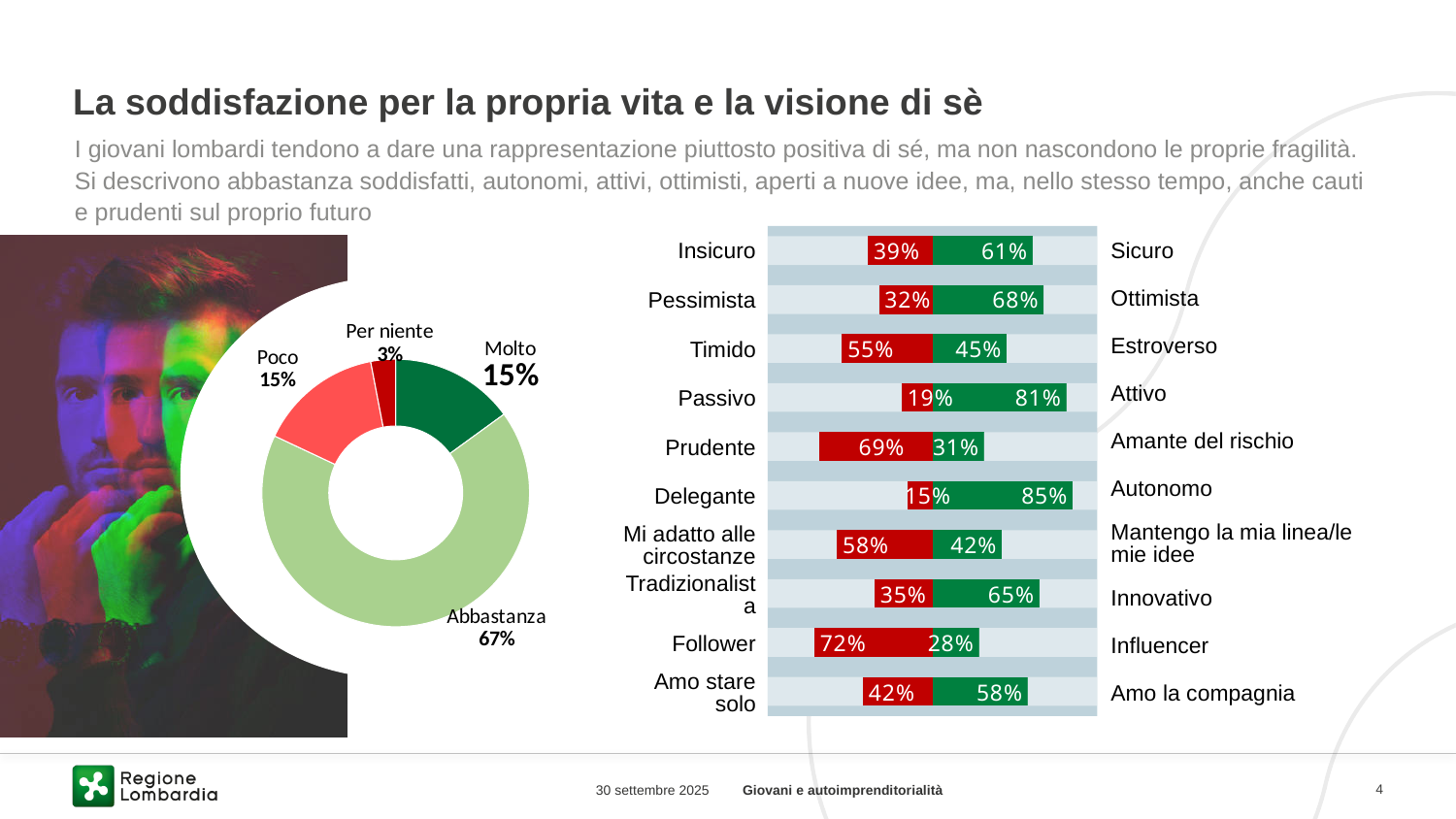
In the bar chart on the right, what percentage is shown for "Prudente"? 69% What type of chart is shown on the left of the slide? Donut chart In the donut chart on the left, what percentage is shown for "Abbastanza"? 67% In the bar chart on the right, how many pairs of opposing traits are shown? 10 In the bar chart on the right, which red (left-side) trait has the highest percentage? Follower In the bar chart on the right, what is the difference between the "Attivo" and "Passivo" percentages? 62 percentage points In the donut chart on the left, what is the difference between the "Abbastanza" and "Molto" percentages? 52 percentage points In the bar chart on the right, what percentage is shown for "Autonomo"? 85% In the bar chart on the right, which is larger: the percentage for "Timido" or for "Estroverso"? Timido In the donut chart on the left, which category has the smallest share? Per niente In the bar chart on the right, which green (right-side) trait has the lowest percentage? Influencer In the donut chart on the left, how many categories are shown? 4